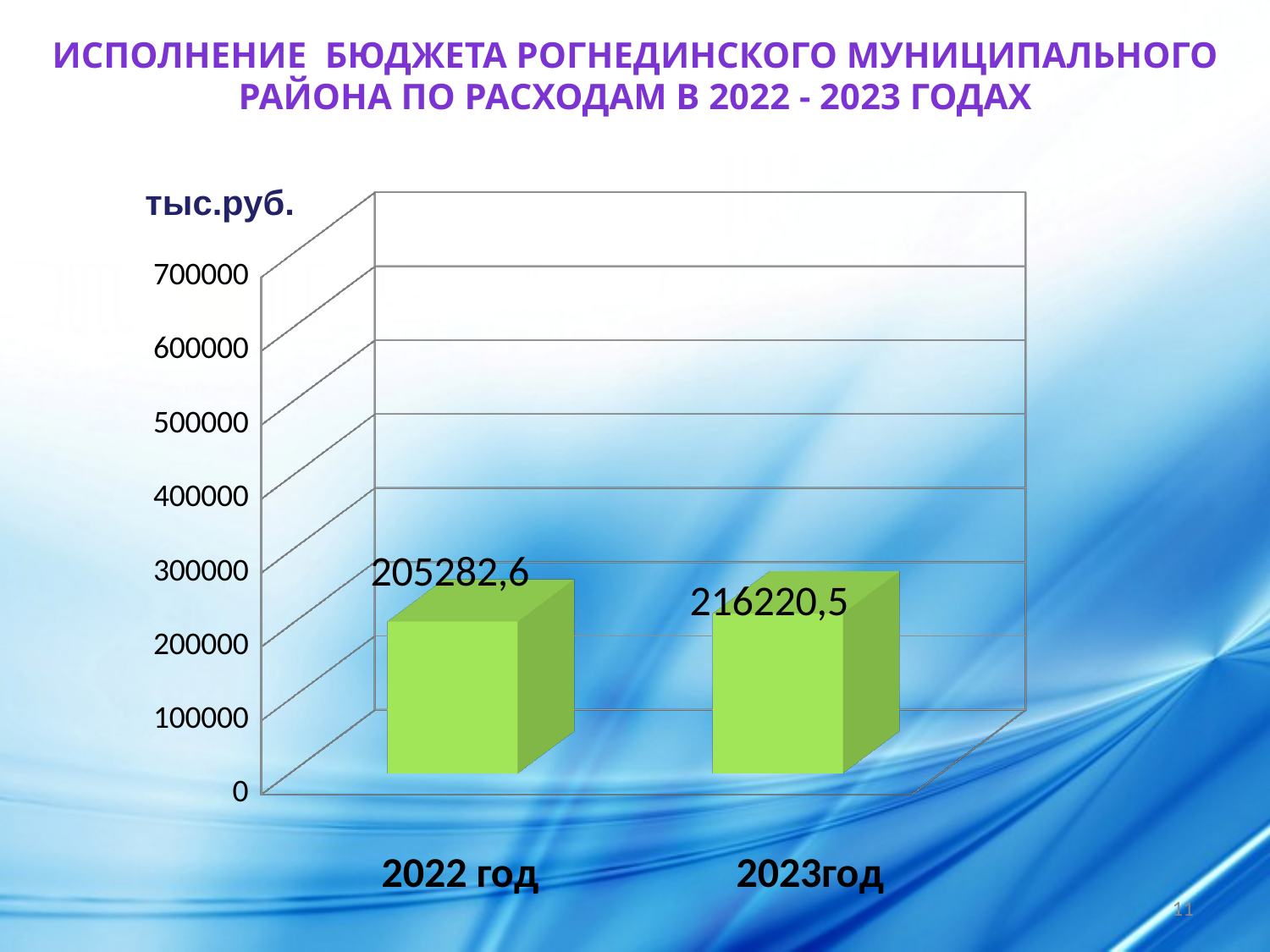
What kind of chart is shown on the slide? bar chart Which year has the higher value? 2023год What is the value for 2023год? 216220,5 Is the value for 2022 год larger or smaller than the value for 2023год? smaller What unit is shown above the vertical axis of the chart? тыс.руб. Is the value for 2023год greater or less than 300000? less What is the difference between the values for 2023год and 2022 год? 10937,9 Which year has the lower value? 2022 год What is the value for 2022 год? 205282,6 Do the values rise or fall from 2022 год to 2023год? rise Is the value for 2022 год greater or less than 200000? greater How many bars are shown in the chart? 2